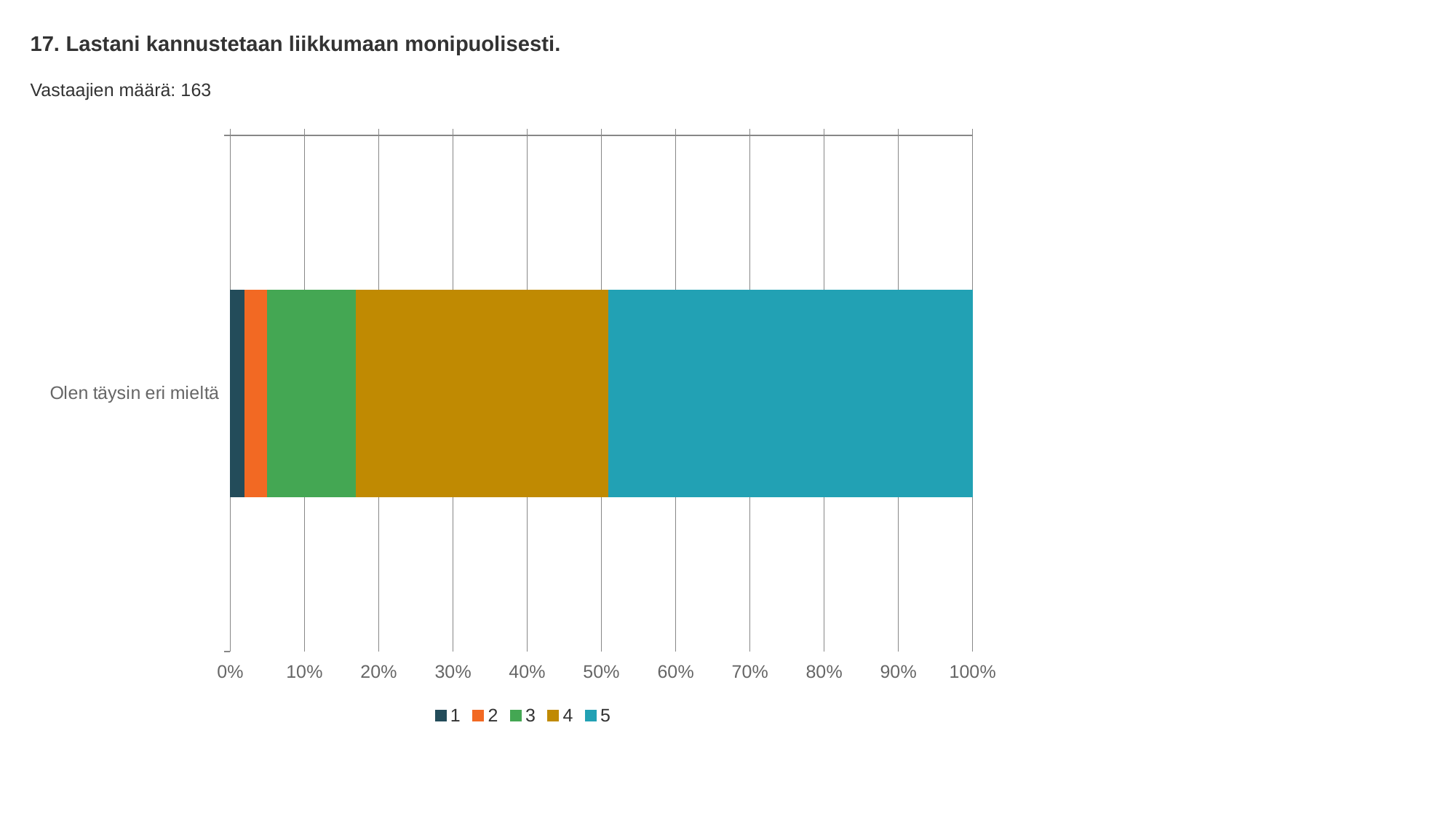
How many respondents (Vastaajien määrä) are reported on the slide? 163 Is the share for series 3 greater or less than 20%? less How many categories are plotted on the y axis? 1 Is the share for series 4 greater or less than 30%? greater Which series takes up a larger share of the bar, series 5 or series 4? 5 Is the share for series 5 greater or less than 40%? greater Which series takes up a larger share of the bar, series 4 or series 3? 4 How many series does the legend list? 5 What is the title of the chart? 17. Lastani kannustetaan liikkumaan monipuolisesti. What kind of chart is shown on the slide? stacked bar chart Which series takes up the largest share of the bar? 5